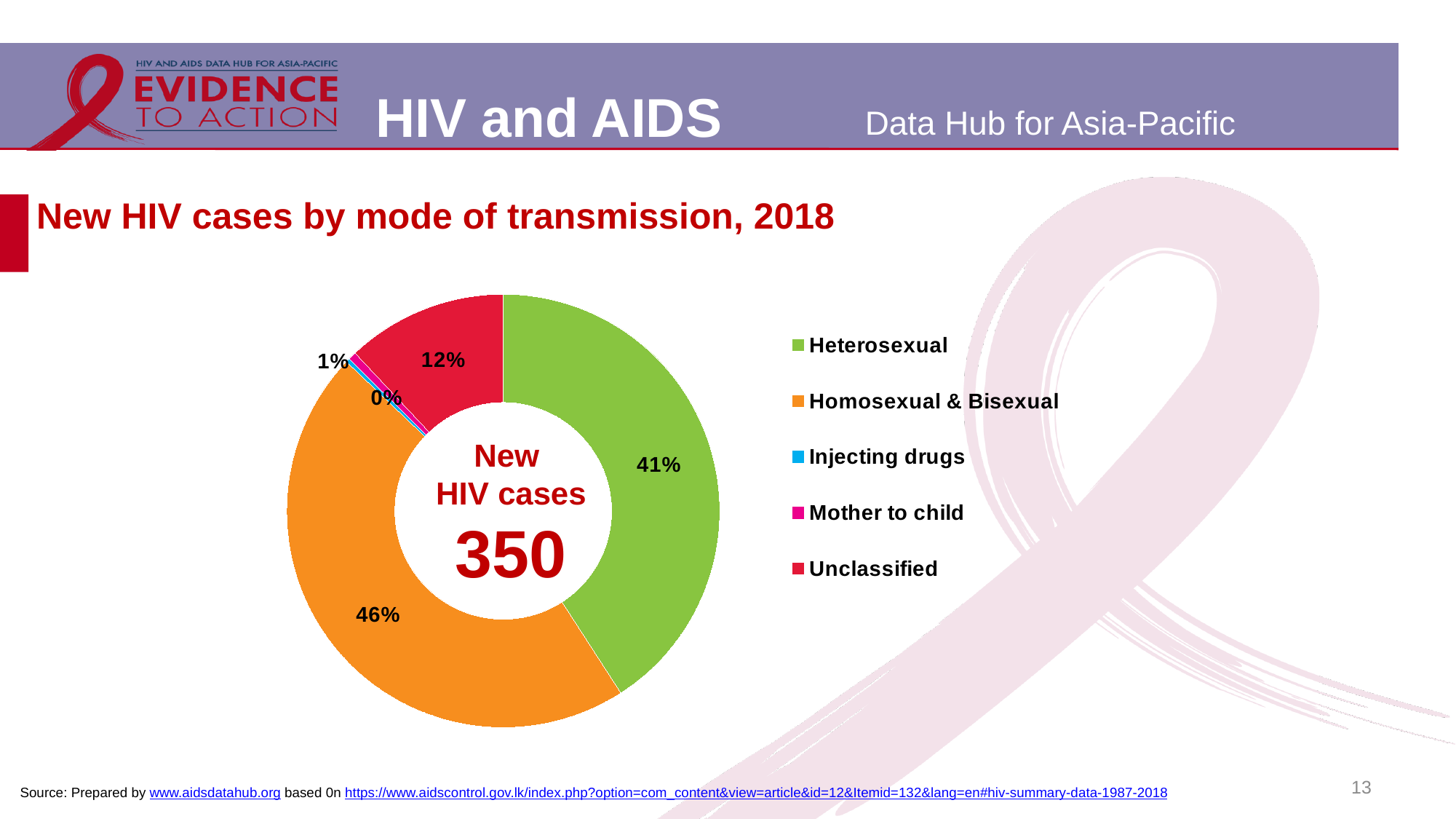
What share of new HIV cases is attributed to Injecting drugs? 0% Which mode of transmission accounts for the smallest share of new HIV cases? Injecting drugs What share of new HIV cases is attributed to Homosexual & Bisexual transmission? 46% What share of new HIV cases is attributed to Mother to child transmission? 1% Which mode of transmission accounts for the largest share of new HIV cases? Homosexual & Bisexual What share of new HIV cases is attributed to Heterosexual transmission? 41% What share of new HIV cases is Unclassified? 12% Which is larger: the Heterosexual share or the Unclassified share? Heterosexual What type of chart is shown on the slide? Doughnut (pie) chart How many modes of transmission are listed in the legend? 5 What total number of new HIV cases is shown in the centre of the chart? 350 What is the difference in percentage points between the Homosexual & Bisexual share and the Heterosexual share? 5 percentage points